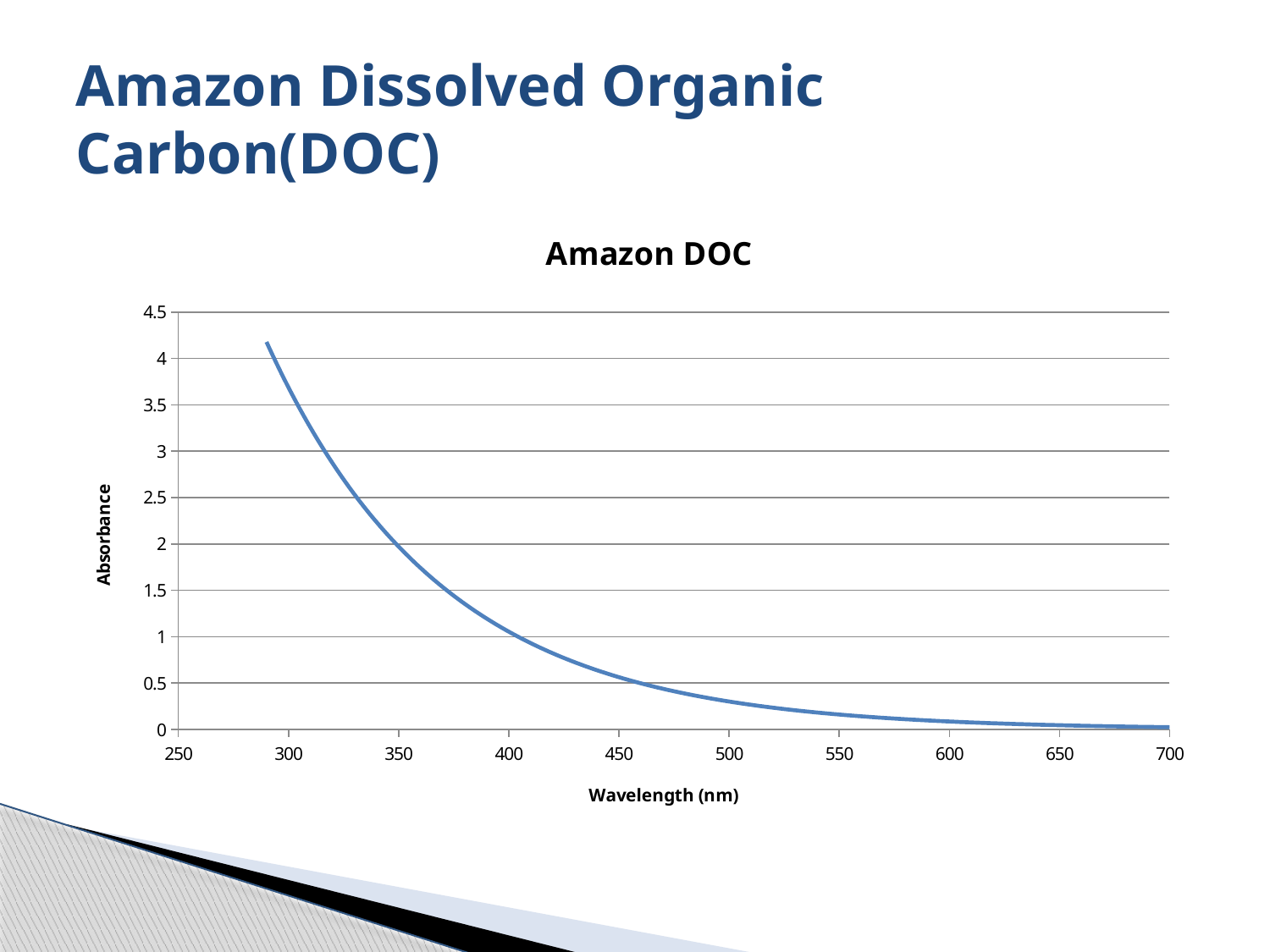
Is the absorbance at 300 nm greater or less than 3.5? greater What is the label of the x axis? Wavelength (nm) What is the title of the chart? Amazon DOC Does absorbance rise or fall as wavelength increases along the x axis? fall Is the absorbance higher at 300 nm or at 500 nm? 300 nm Is the absorbance at 600 nm greater or less than 0.5? less What kind of chart is shown on the slide? line chart Is the absorbance at 450 nm greater or less than 1? less